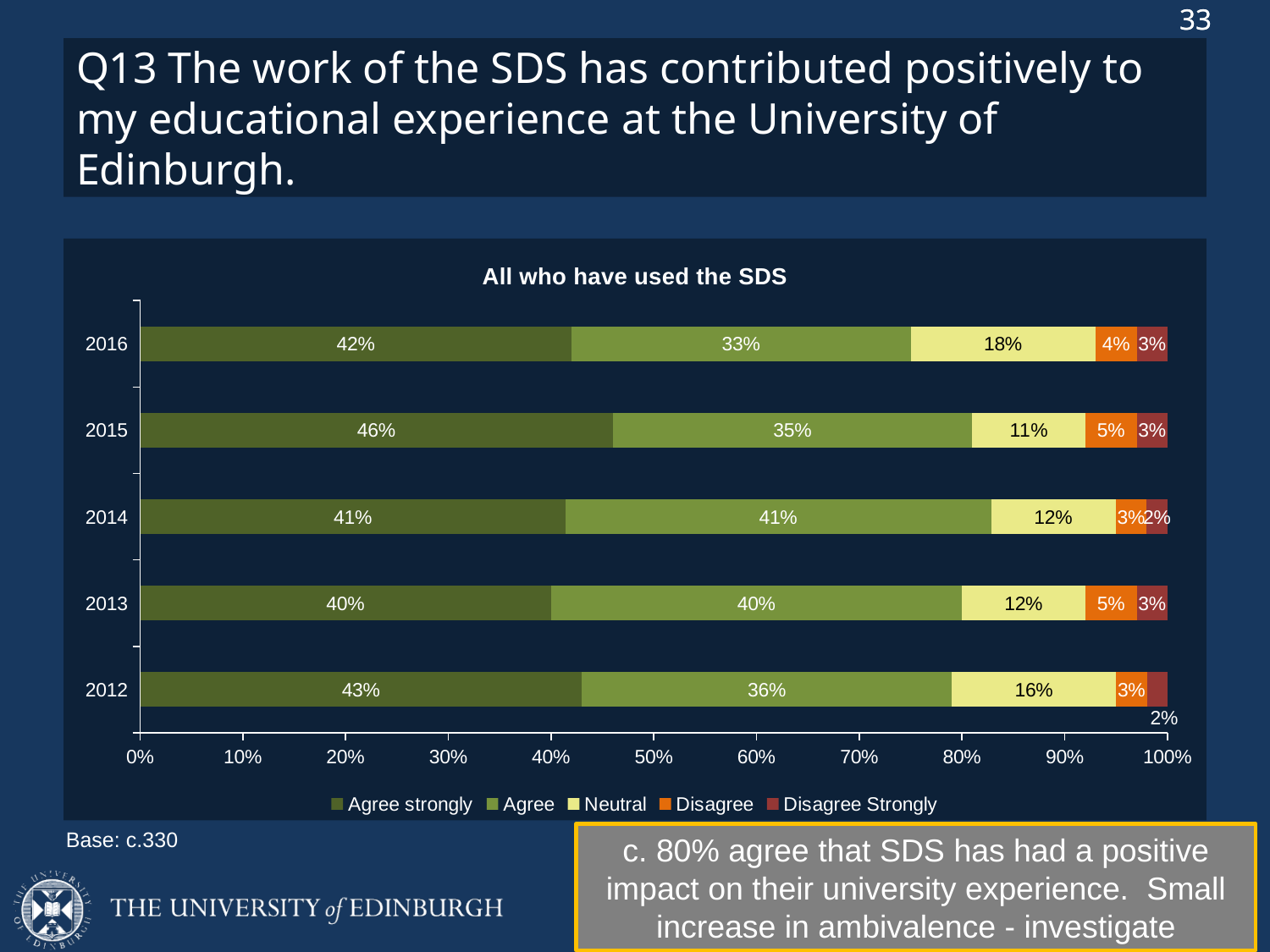
What is the Agree strongly value for 2015? 46% Which is larger, the Agree value for 2014 or the Agree value for 2016? 2014 What is the Agree value for 2012? 36% What is the Neutral value for 2016? 18% Which year has the highest Agree strongly value? 2015 What is the combined Agree strongly and Agree value for 2014? 82% What is the title of the chart? All who have used the SDS What is the difference between the Neutral values for 2016 and 2015? 7% How many series does the legend list? 5 How many years are shown on the chart? 5 Which year has the lowest Neutral value? 2015 What kind of chart is shown on the slide? Stacked bar chart